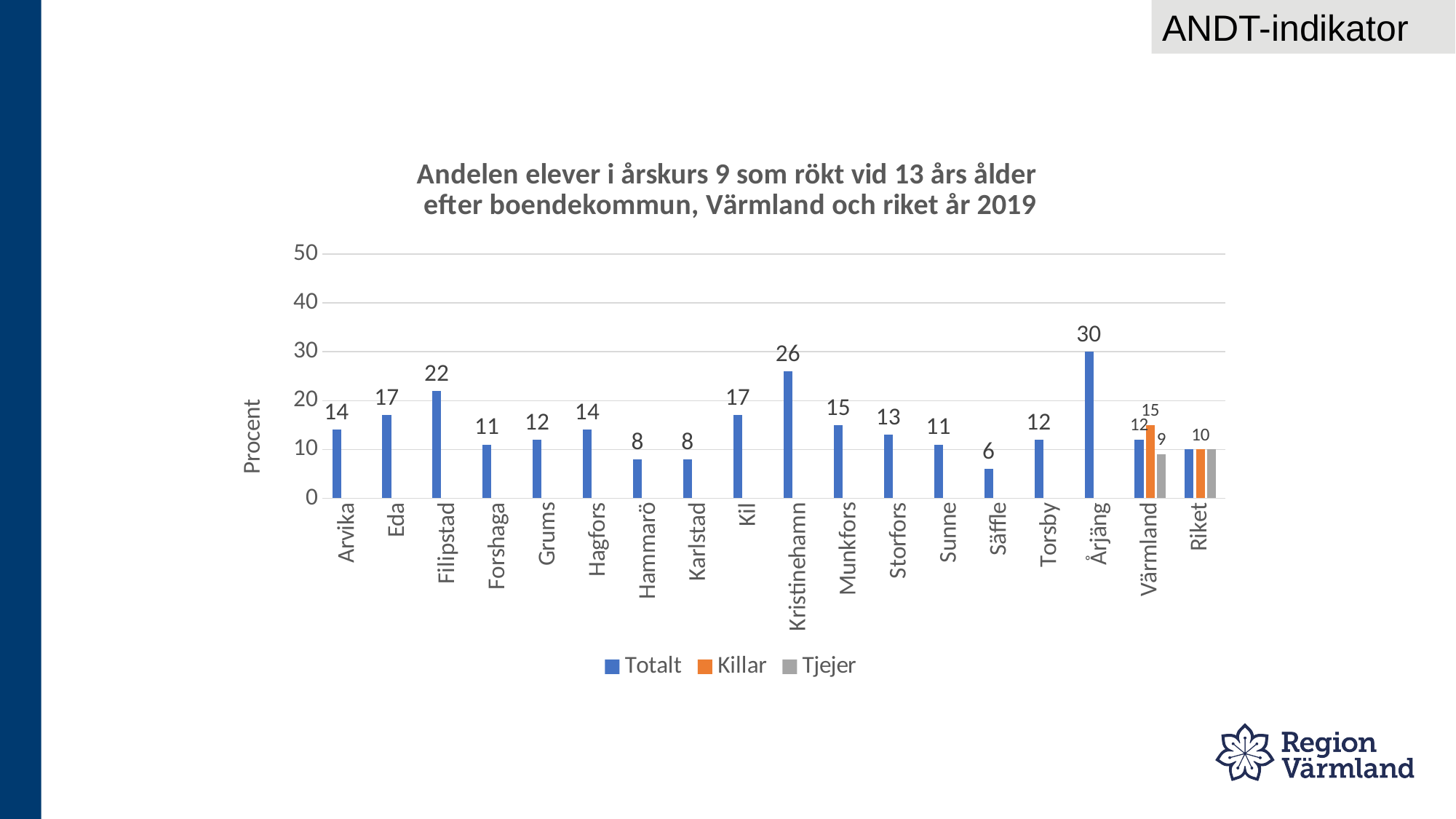
What is the difference between the Totalt values for Filipstad and Eda? 5 Which has a higher Totalt value, Hagfors or Munkfors? Munkfors What is the Tjejer value for Värmland? 9 What kind of chart is shown on the slide? Bar chart Which municipality has the highest Totalt value? Årjäng How many categories are shown on the x axis? 18 What is the Totalt value for Årjäng? 30 How many series does the legend list? 3 What is the Killar value for Värmland? 15 Is the Totalt value for Riket greater or less than 20? less What is the Totalt value for Kristinehamn? 26 Which municipality has the lowest Totalt value? Säffle